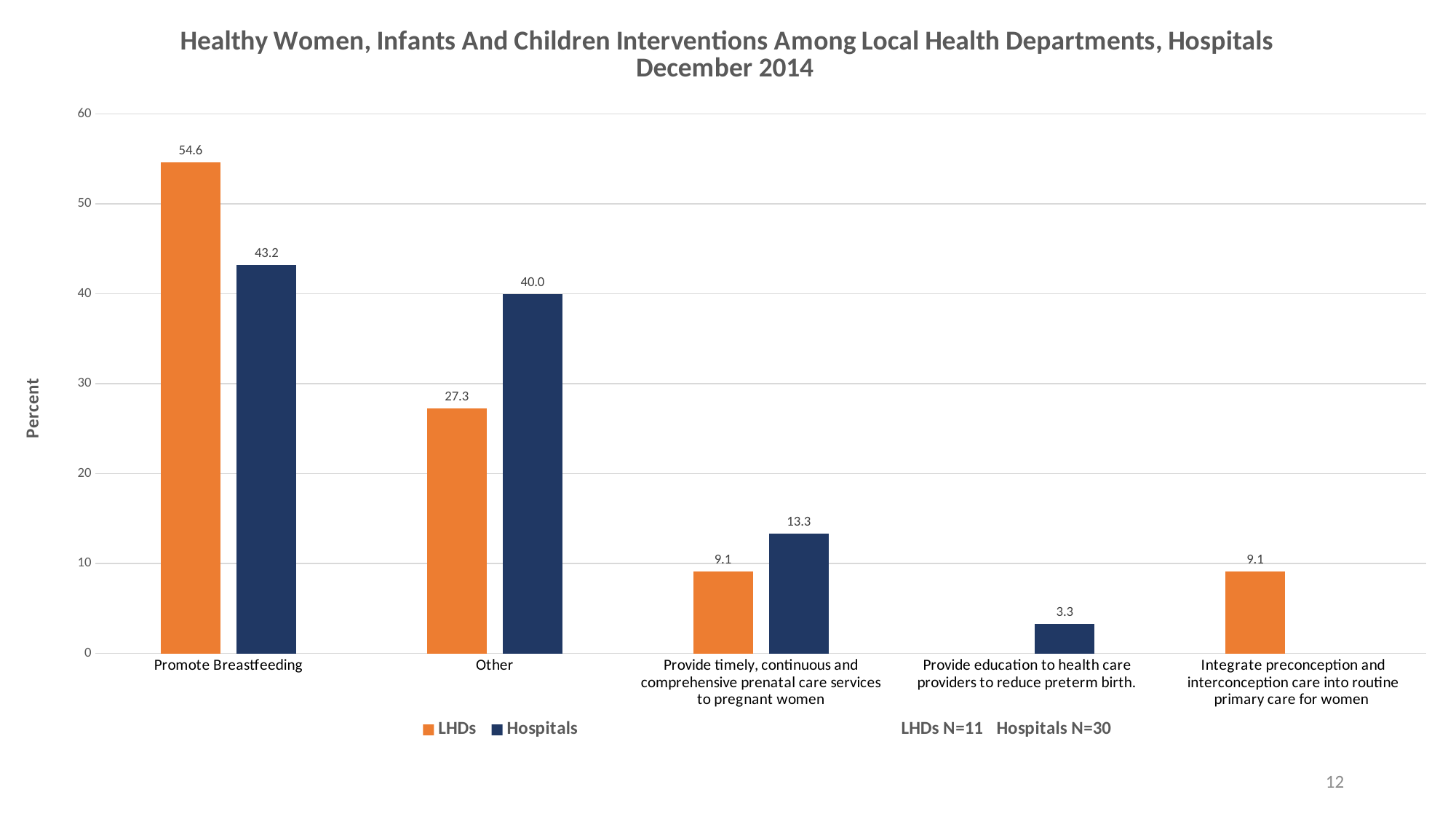
For Provide timely, continuous and comprehensive prenatal care services to pregnant women, which is larger: LHDs or Hospitals? Hospitals What is the difference between the Hospitals and LHDs values for Other? 12.7 What is the Hospitals value for Provide education to health care providers to reduce preterm birth? 3.3 How many categories are shown on the x axis? 5 What kind of chart is shown on the slide? Bar chart What is the Hospitals value for Other? 40.0 How many series does the legend list? 2 Which category has the lowest Hospitals value among those with a Hospitals bar? Provide education to health care providers to reduce preterm birth. What is the LHDs value for Promote Breastfeeding? 54.6 Which category has the highest LHDs value? Promote Breastfeeding Is the Hospitals value for Promote Breastfeeding greater or less than 40? greater What is the difference between the LHDs and Hospitals values for Promote Breastfeeding? 11.4